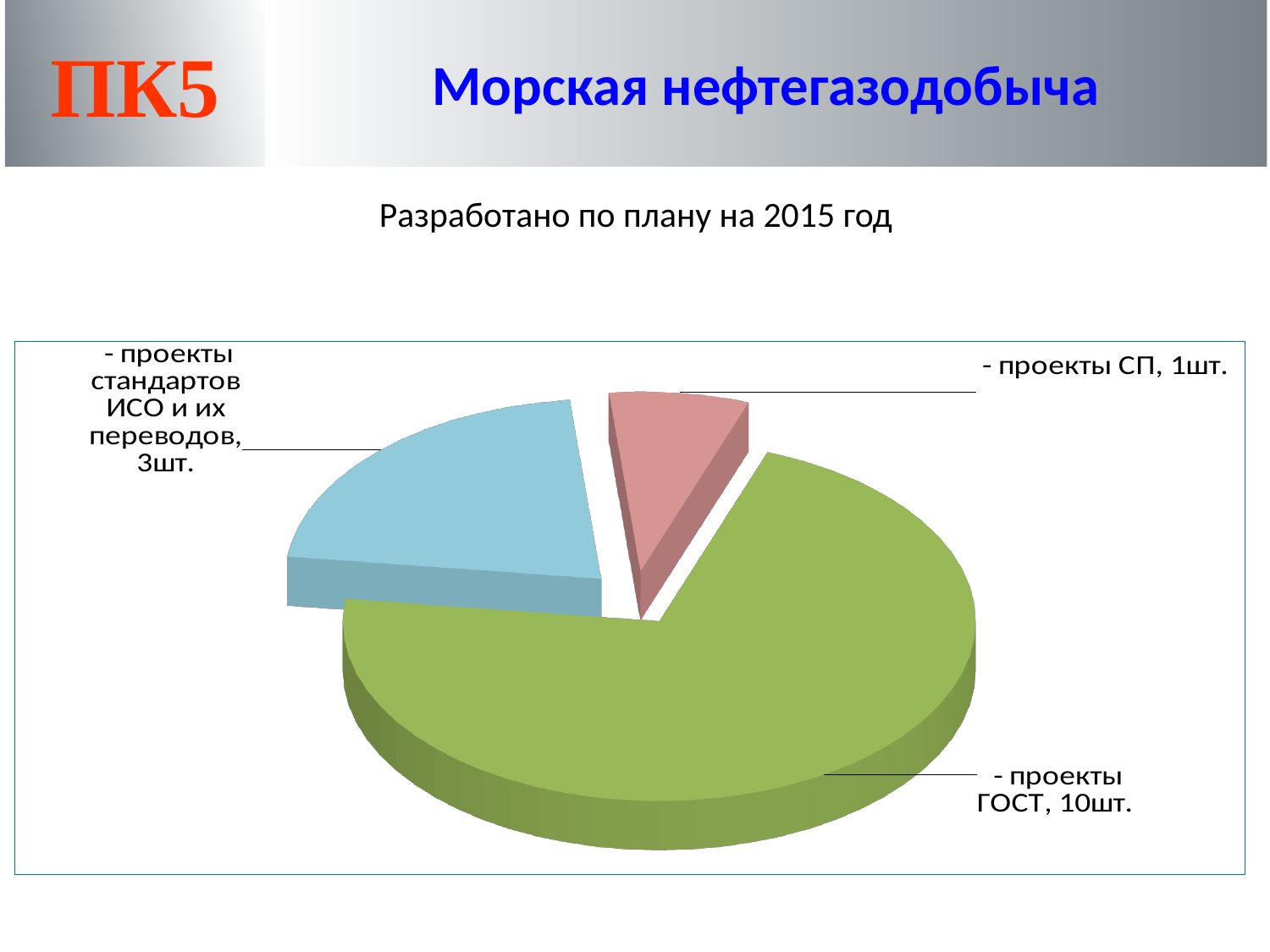
What colour is the slice for проекты СП? pink What is the value for проекты СП? 1шт. Which category has the largest slice of the pie? проекты ГОСТ What is the total of all three slices in the pie chart? 14 What kind of chart is shown on the slide? pie chart How many slices does the pie chart have? 3 Which category has the smallest slice of the pie? проекты СП What is the difference between the number of проекты ГОСТ and проекты стандартов ИСО и их переводов? 7 Which is larger: проекты стандартов ИСО и их переводов or проекты СП? проекты стандартов ИСО и их переводов What is the value for проекты ГОСТ? 10шт. What share of the pie does проекты ГОСТ represent, as a fraction of the total? 10 out of 14 What is the value for проекты стандартов ИСО и их переводов? 3шт.